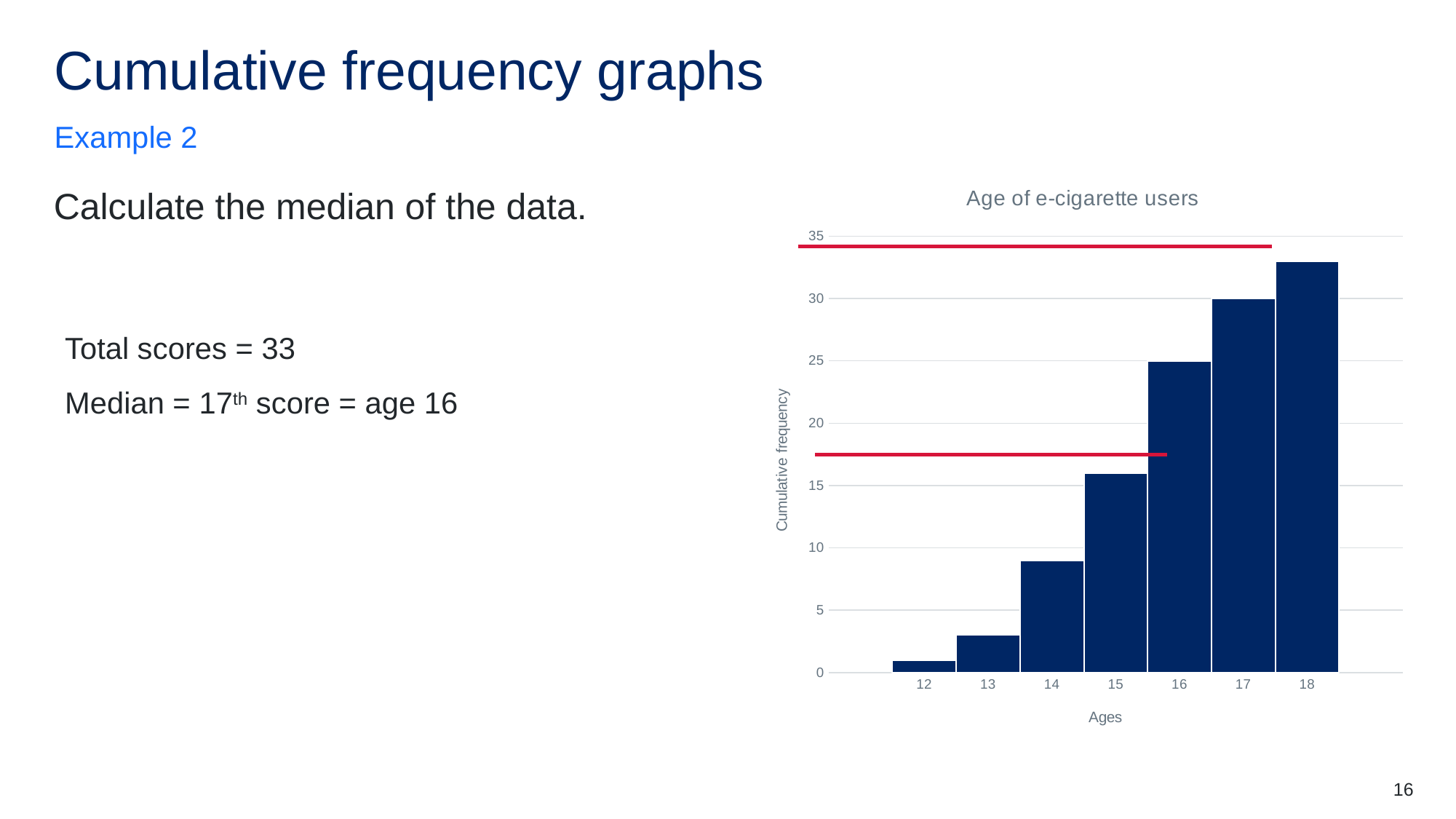
Is the cumulative frequency for age 18 greater or less than 30? greater What is the title of the chart? Age of e-cigarette users What is the cumulative frequency for age 16? 25 What kind of chart is shown on the slide? bar chart Is the cumulative frequency for age 14 greater or less than 10? less What is the label on the vertical axis of the chart? Cumulative frequency What is the difference between the cumulative frequencies for age 17 and age 16? 5 What is the cumulative frequency for age 17? 30 How many age categories are plotted on the x axis? 7 Which age has the highest cumulative frequency? 18 Which age has the lowest cumulative frequency? 12 Do the bar values rise or fall as age increases along the x axis? rise